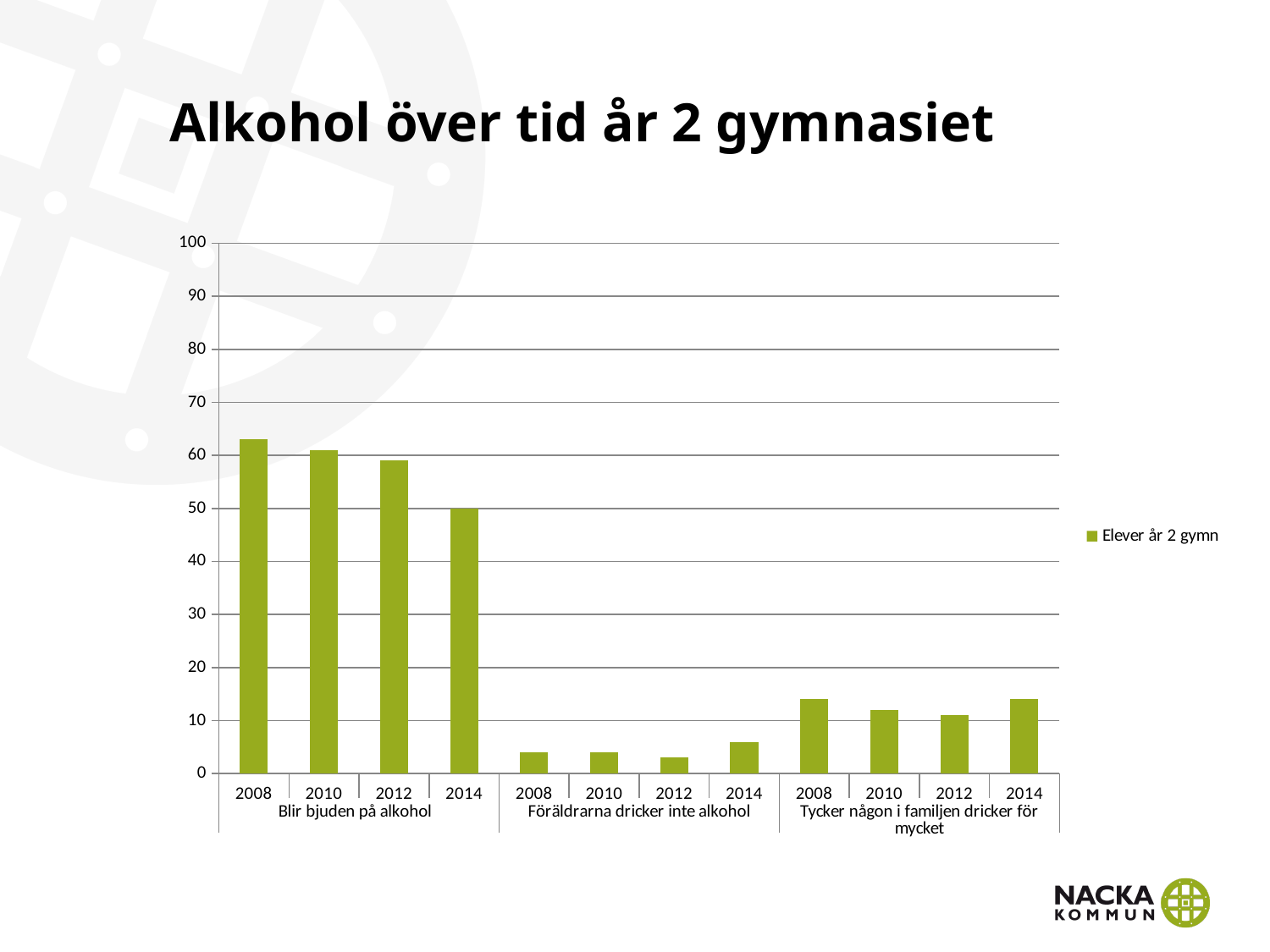
Is the value for 2014 under 'Föräldrarna dricker inte alkohol' greater or less than 10? less How many bars are plotted in the chart? 12 Which bar is the lowest in the chart? 2012, Föräldrarna dricker inte alkohol What is the title of the slide? Alkohol över tid år 2 gymnasiet Do the values for 'Blir bjuden på alkohol' rise or fall from 2008 to 2014? fall What is the name of the series shown in the legend? Elever år 2 gymn Is the value for 2012 under 'Tycker någon i familjen dricker för mycket' greater or less than 10? greater Is the value for 2008 under 'Blir bjuden på alkohol' greater or less than 60? greater Which bar is the highest in the chart? 2008, Blir bjuden på alkohol Which is larger: the 2014 value for 'Blir bjuden på alkohol' or the 2014 value for 'Tycker någon i familjen dricker för mycket'? 2014 Blir bjuden på alkohol What kind of chart is shown on the slide? bar chart How many series does the legend list? 1